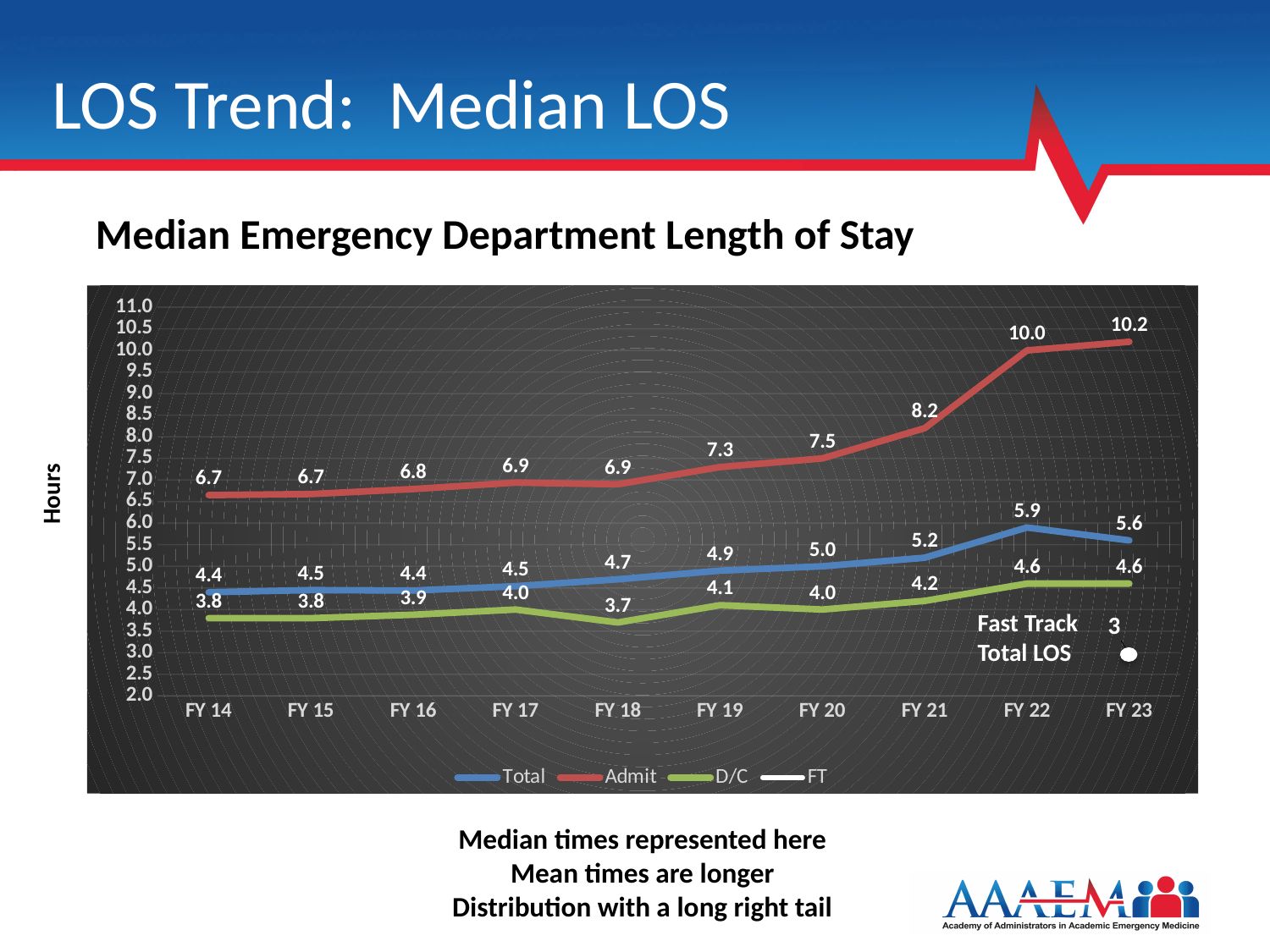
What is the D/C median LOS in FY 18? 3.7 What is the Admit median LOS in FY 23? 10.2 What kind of chart is shown on the slide? Line chart In which fiscal year is the Admit median LOS highest? FY 23 Which is larger, the Total median LOS in FY 22 or in FY 23? FY 22 How many fiscal years are shown on the x axis? 10 In which fiscal year is the D/C median LOS lowest? FY 18 What is the Fast Track (FT) Total LOS value shown for FY 23? 3 What is the difference between the Admit median LOS in FY 23 and in FY 14? 3.5 Does the Admit median LOS generally rise or fall from FY 14 to FY 23? Rise How many series does the legend list? 4 What is the Total median LOS in FY 22? 5.9